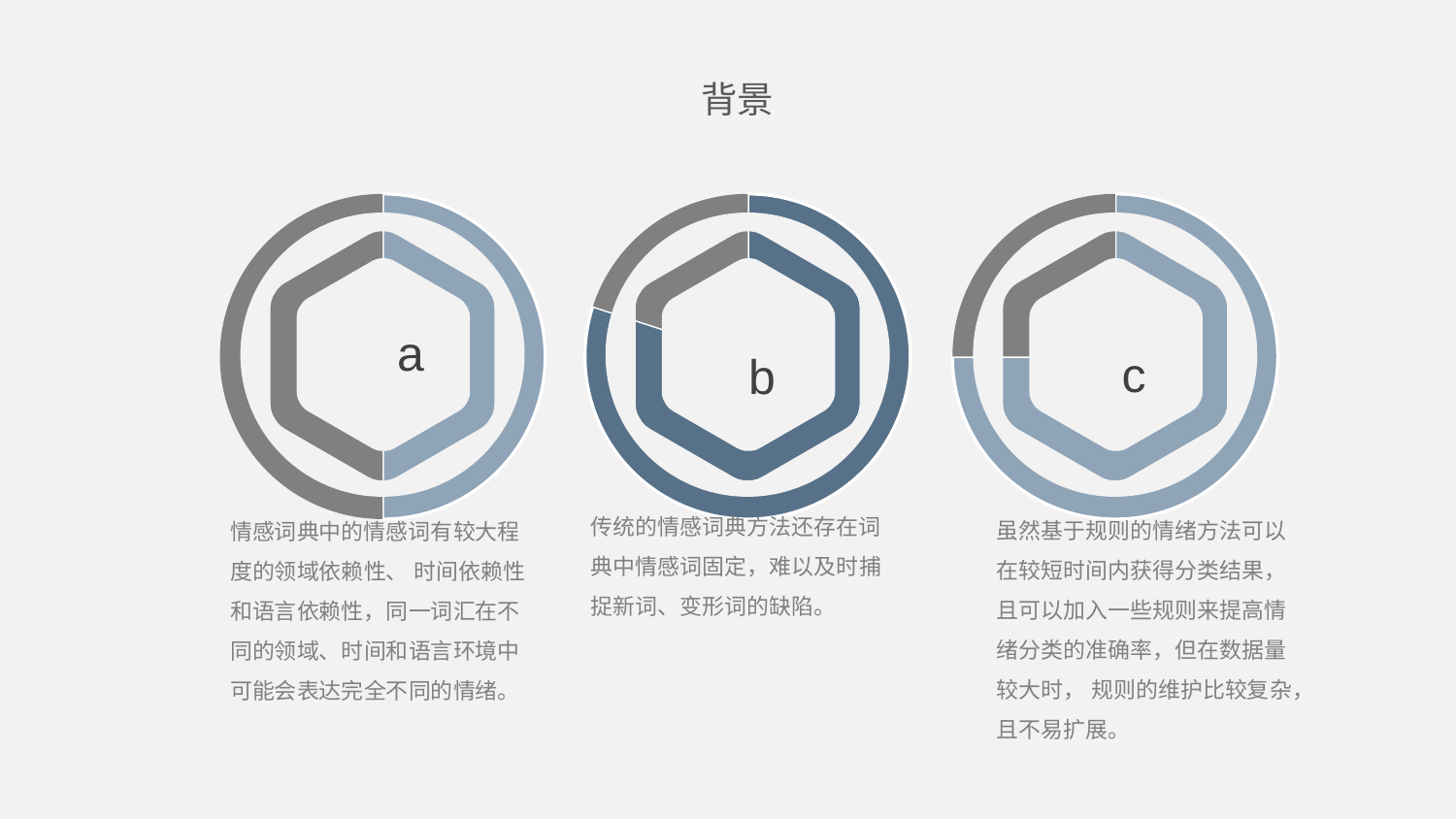
How many segments does the outer ring of the chart labelled "c" have? 2 What is the title of the slide? 背景 In the chart labelled "c", which segment is larger, the light blue one or the grey one? light blue How many ring charts are shown on the slide? 3 In the chart labelled "b", which segment is larger, the dark blue one or the grey one? dark blue What letter is printed in the centre of the middle chart? b What kind of chart is the shape labelled "a"? doughnut chart How many segments does the outer ring of the chart labelled "b" have? 2